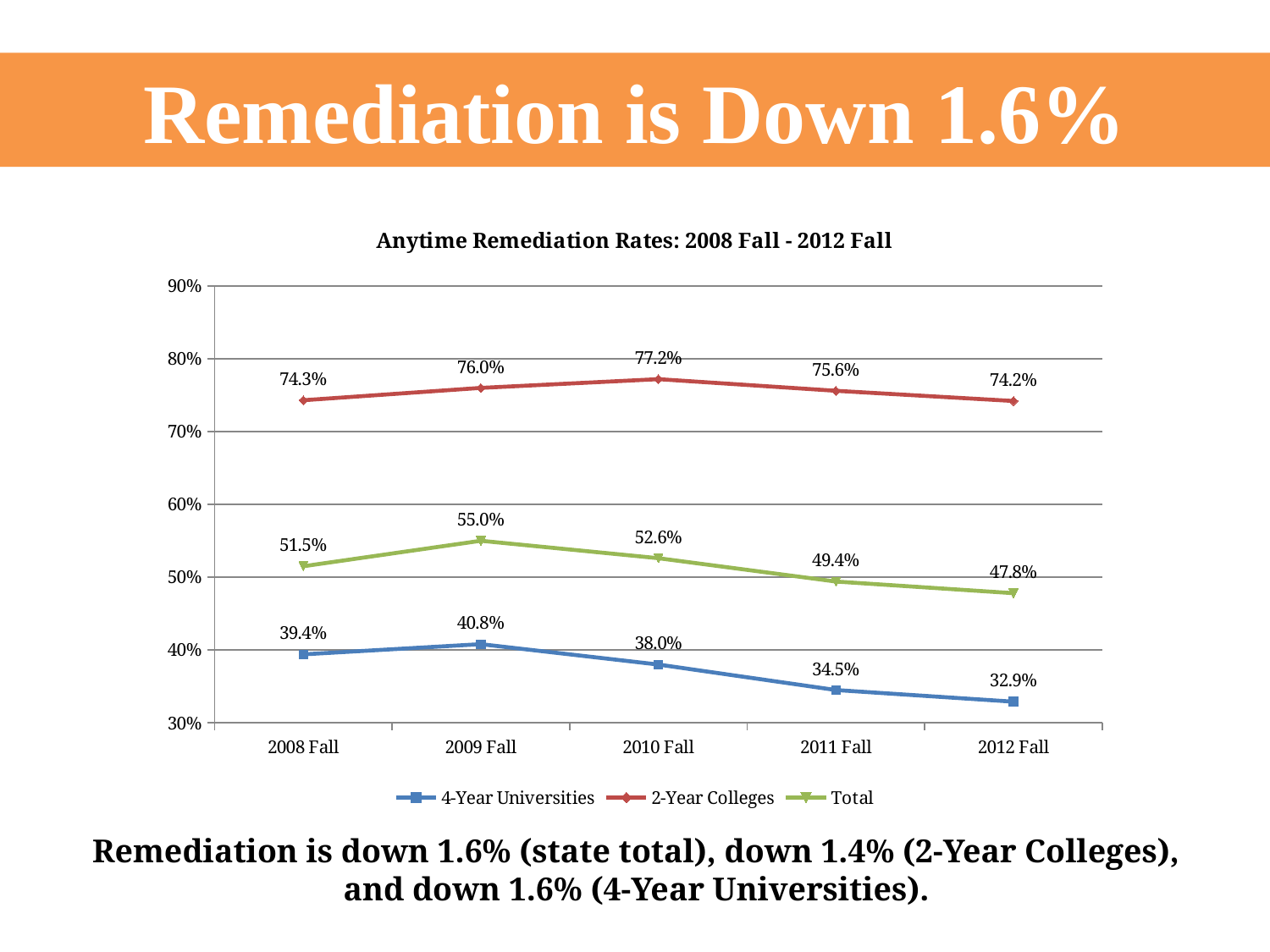
Is the 4-Year Universities value for 2011 Fall greater or less than 40%? less In which year is the Total remediation rate lowest? 2012 Fall How many time points are plotted on the x axis? 5 What is the 2-Year Colleges remediation rate for 2010 Fall? 77.2% Which is larger, the Total rate in 2010 Fall or the Total rate in 2011 Fall? 2010 Fall What is the 4-Year Universities remediation rate for 2012 Fall? 32.9% How many series does the legend list? 3 What is the difference between the 2-Year Colleges rate and the 4-Year Universities rate in 2008 Fall? 34.9% What is the Total remediation rate for 2009 Fall? 55.0% In which year is the 4-Year Universities remediation rate highest? 2009 Fall What kind of chart is shown on the slide? line chart What is the title of the chart? Anytime Remediation Rates: 2008 Fall - 2012 Fall